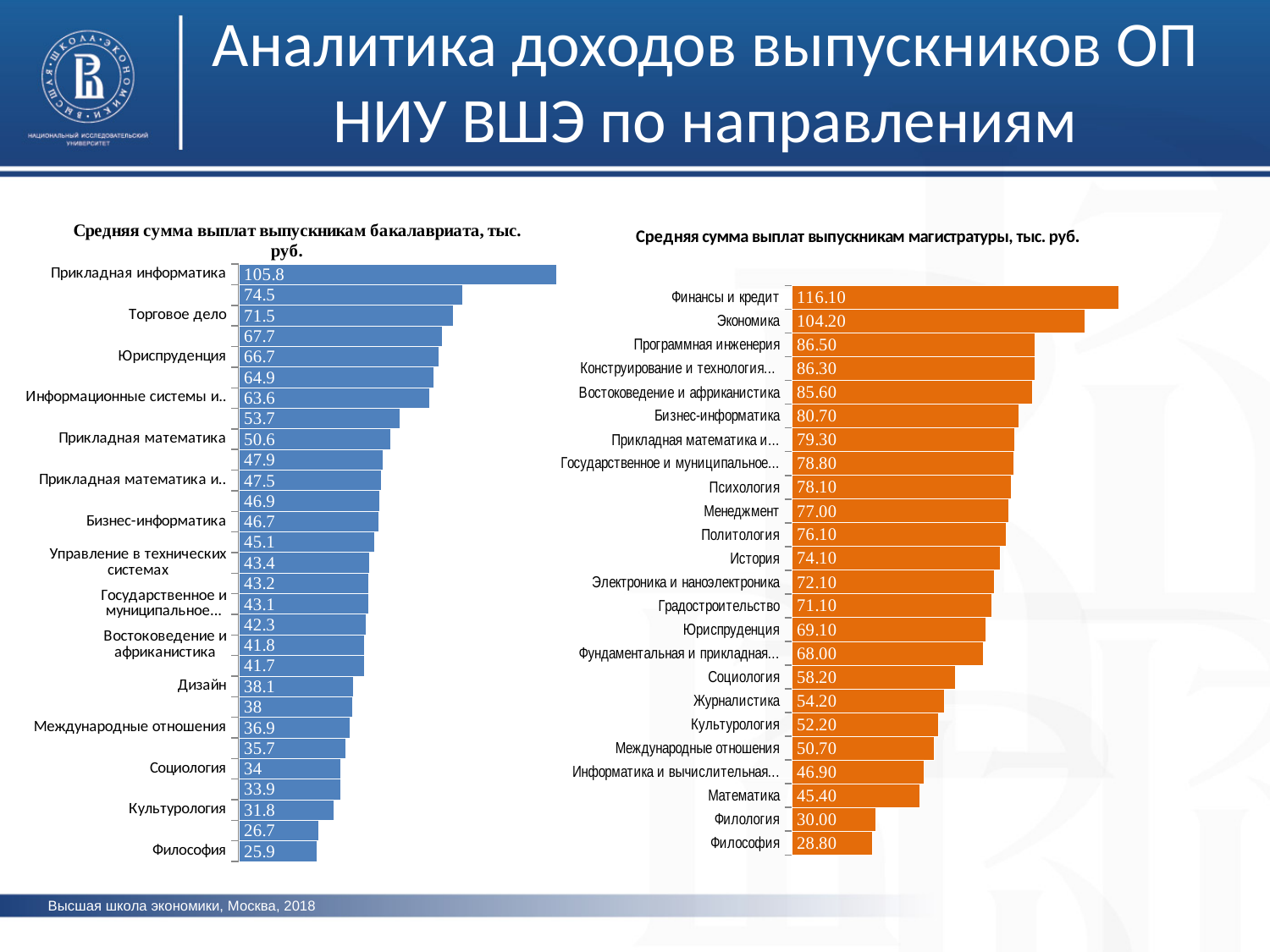
In the chart on the right (master's graduates), what is the value for Психология? 78.10 In the chart on the right (master's graduates), what is the difference between Финансы и кредит and Экономика? 11.90 In the chart on the right (master's graduates), which is larger: Социология or Журналистика? Социология In the chart on the left (bachelor's graduates), what is the value for Прикладная информатика? 105.8 How many categories are shown in the chart on the right (master's graduates)? 24 In the chart on the left (bachelor's graduates), which category has the highest value? Прикладная информатика In the chart on the right (master's graduates), what is the value for Финансы и кредит? 116.10 In the chart on the left (bachelor's graduates), what is the value for Социология? 34 In the chart on the left (bachelor's graduates), what is the difference between Торговое дело and Юриспруденция? 4.8 What colour are the bars in the chart on the right (master's graduates)? Orange What type of chart is used on the left for bachelor's graduates? Bar chart In the chart on the right (master's graduates), which category has the lowest value? Философия